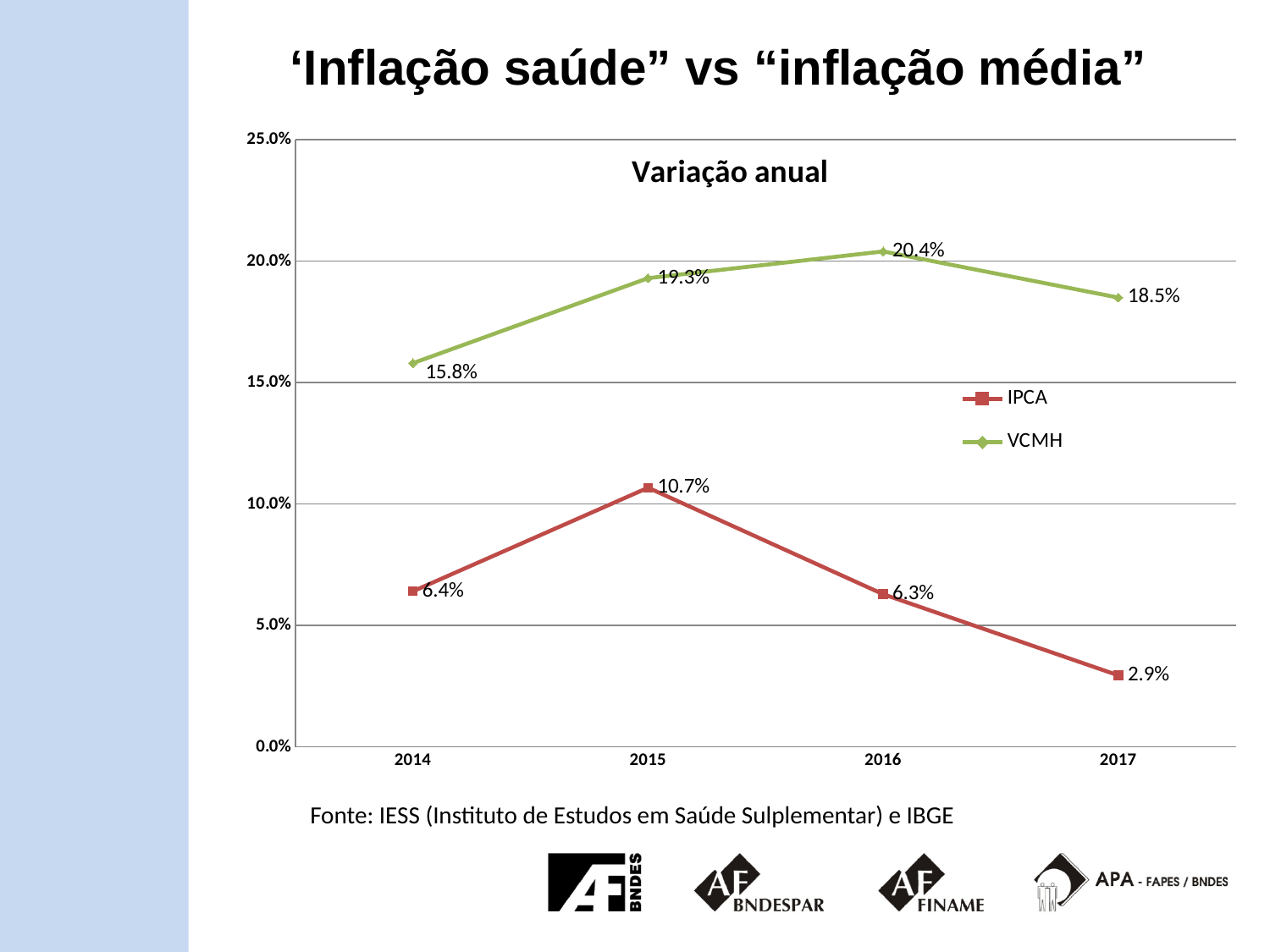
How many series does the legend list? 2 Does the IPCA series rise or fall from 2015 to 2017? fall What is the IPCA value for 2017? 2.9% How many years are shown on the x axis? 4 What kind of chart is shown? line chart What is the IPCA value for 2015? 10.7% What is the VCMH value for 2014? 15.8% Which is larger in 2015, IPCA or VCMH? VCMH What is the difference between VCMH and IPCA in 2017? 15.6% What is the VCMH value for 2016? 20.4% In which year is the IPCA series lowest? 2017 In which year is the VCMH series highest? 2016